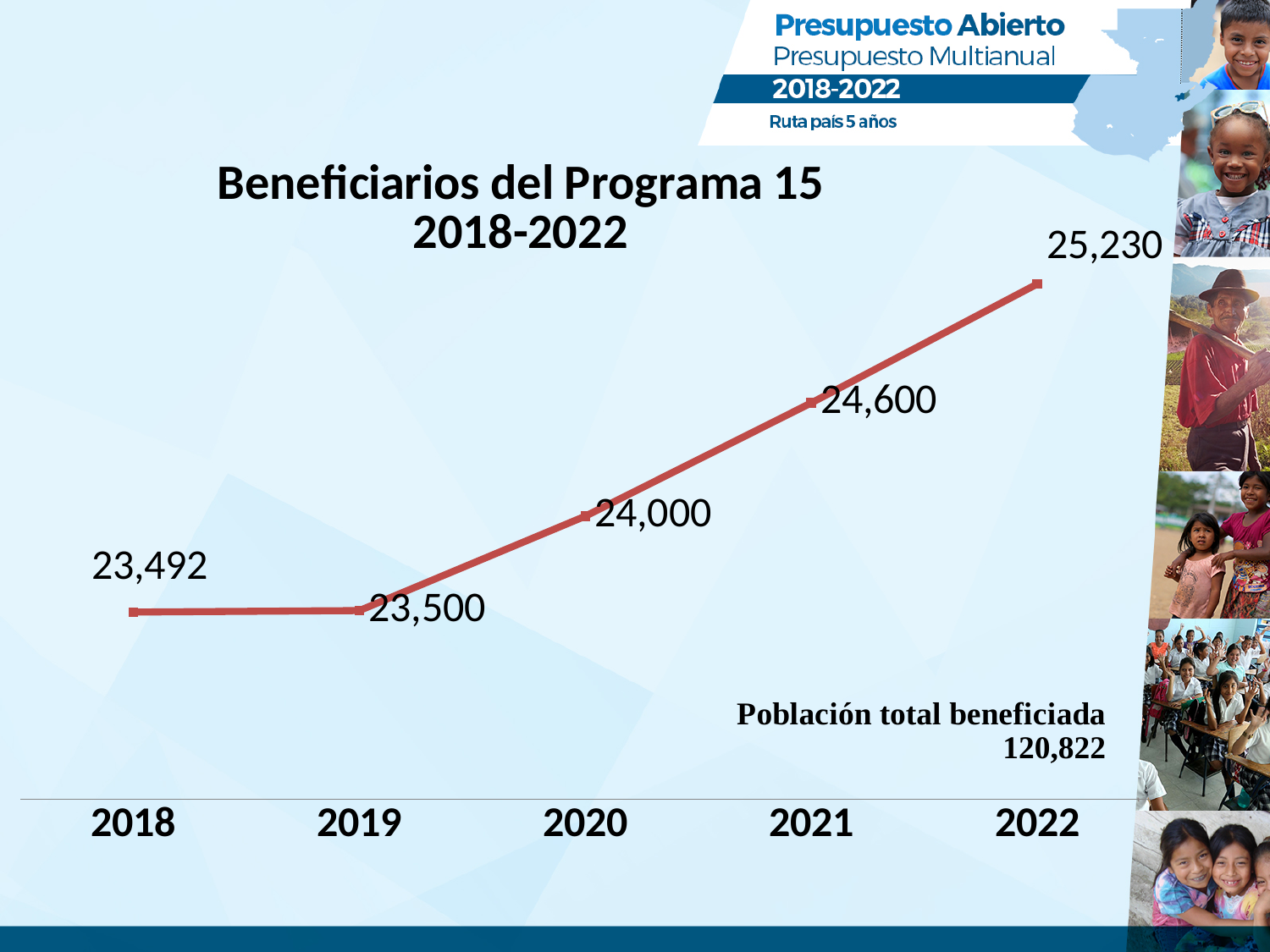
What is the value for 2021? 24,600 What is the value for 2018? 23,492 What is the value for 2022? 25,230 What kind of chart is this? line chart What is the difference between the values for 2021 and 2020? 600 What is the difference between the values for 2022 and 2018? 1,738 Which year has the lowest value? 2018 How many years are plotted on the chart? 5 Do the values rise or fall from 2018 to 2022? rise Which is larger, the value for 2019 or the value for 2021? 2021 What is the value for 2020? 24,000 Which year has the highest value? 2022